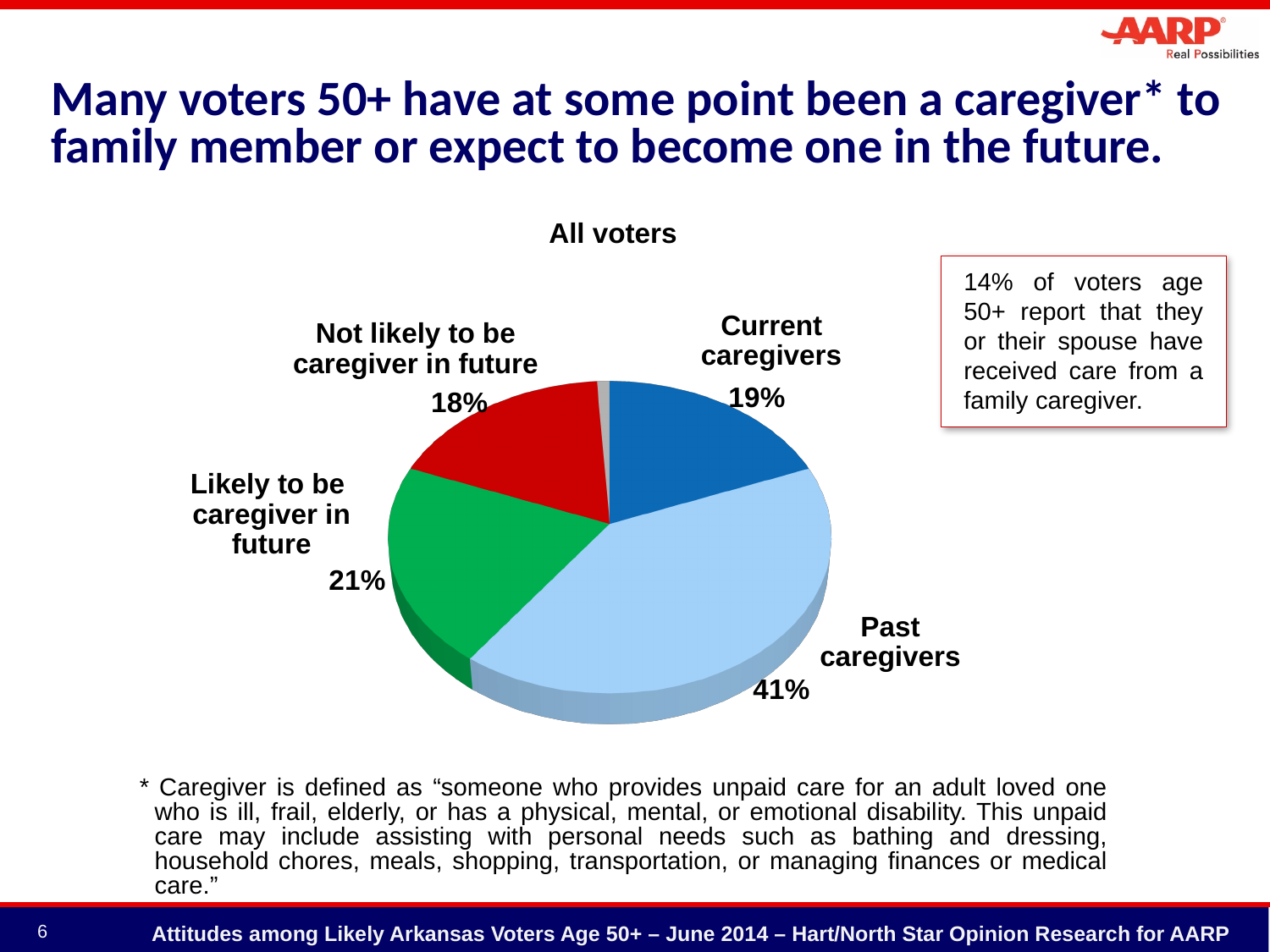
What colour is the slice for past caregivers? Light blue What is the combined percentage of current caregivers and past caregivers? 60% What is the title of the chart? All voters What percentage of voters are past caregivers? 41% Which category has the largest share of the pie? Past caregivers What percentage of voters are likely to be a caregiver in the future? 21% What percentage of voters are current caregivers? 19% Which labeled category has the smallest share of the pie? Not likely to be caregiver in future What percentage of voters are not likely to be a caregiver in the future? 18% What is the difference in percentage points between past caregivers and current caregivers? 22 Which is larger: the share of voters likely to be a caregiver in the future or the share not likely to be a caregiver in the future? Likely to be caregiver in future What kind of chart is shown on the slide? Pie chart